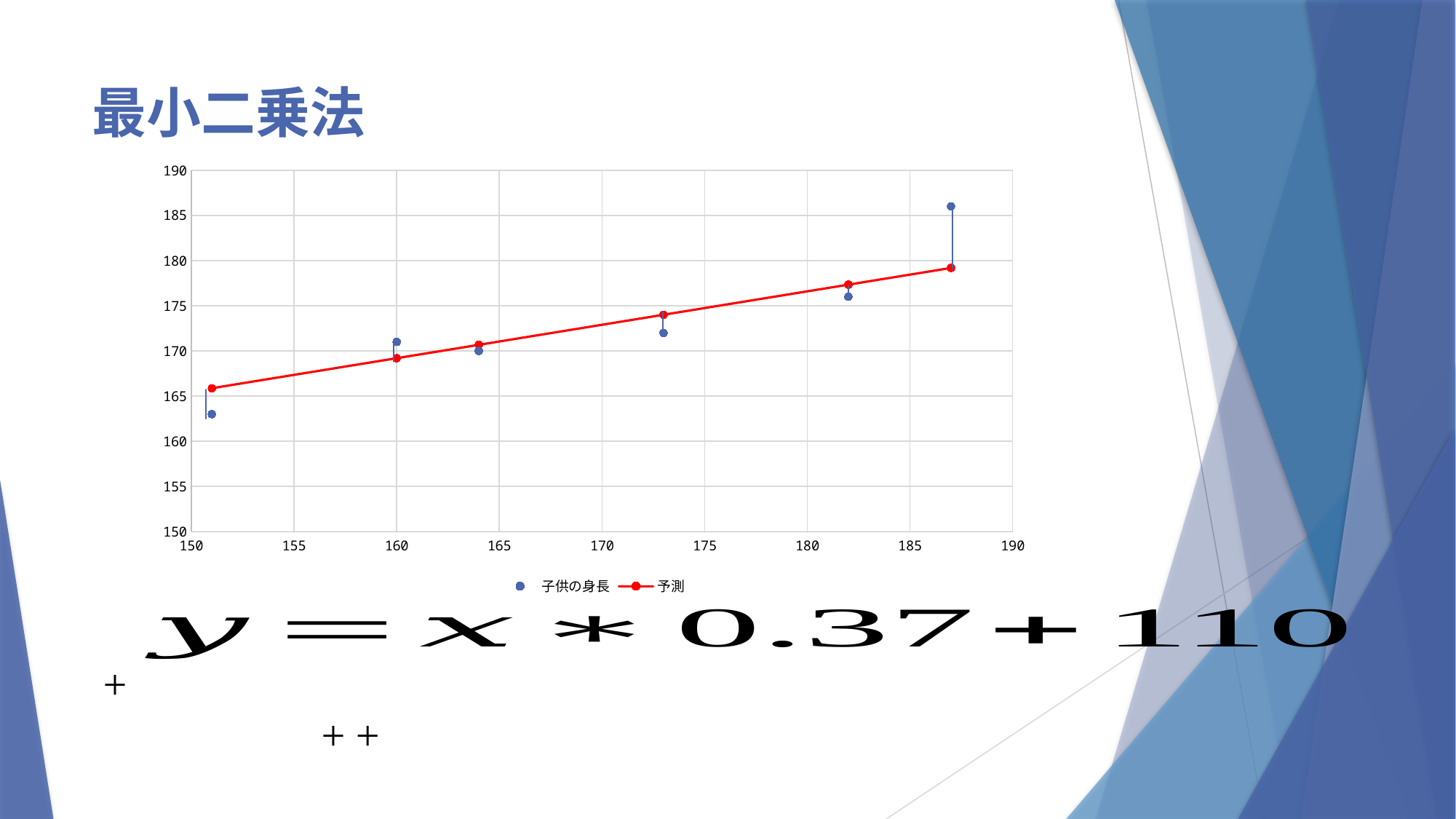
At the rightmost x position, which is higher: the 子供の身長 point or the 予測 point? 子供の身長 How many series does the chart legend list? 2 Is the 予測 value at the rightmost point greater or less than 180? less Is the highest 子供の身長 value greater or less than 185? greater What kind of chart is shown on the slide? scatter chart Is the 子供の身長 value near x = 160 greater or less than 170? greater What are the two series named in the chart legend? 子供の身長 and 予測 How many 子供の身長 data points are plotted on the chart? 6 What colour is the 予測 line on the chart? red Does the 予測 line rise or fall as x increases along the x axis? rises At the leftmost x position, which is higher: the 子供の身長 point or the 予測 point? 予測